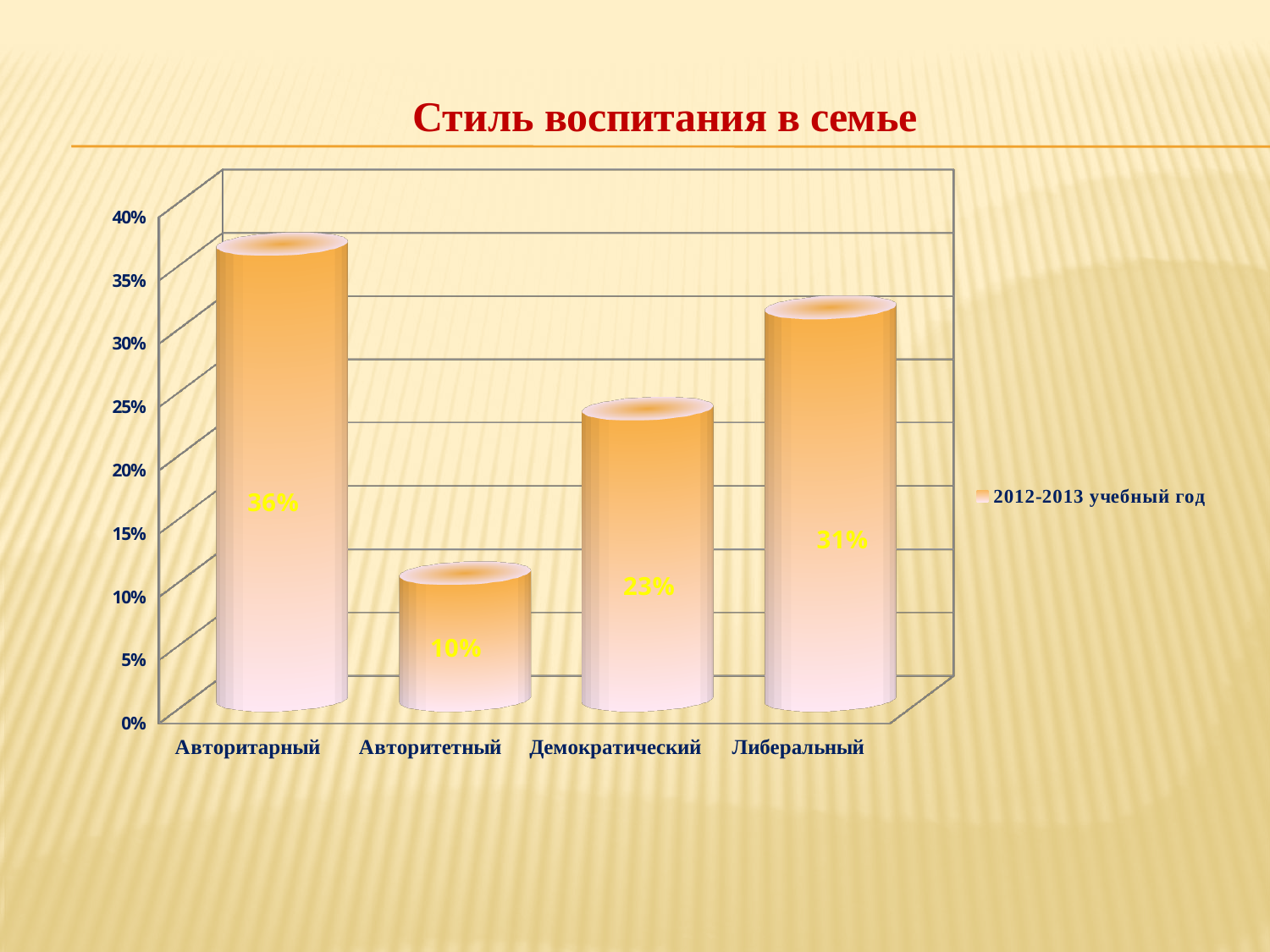
What is the value for Авторитетный? 10% What series does the legend list? 2012-2013 учебный год Which category has the lowest value? Авторитетный How many categories are shown on the x axis? 4 Which is larger, the value for Демократический or the value for Либеральный? Либеральный What is the value for Демократический? 23% Which category has the highest value? Авторитарный Is the value for Демократический greater or less than 25%? less What kind of chart is shown on the slide? bar chart What is the difference between the values for Авторитарный and Либеральный? 5% What is the value for Авторитарный? 36% What is the value for Либеральный? 31%